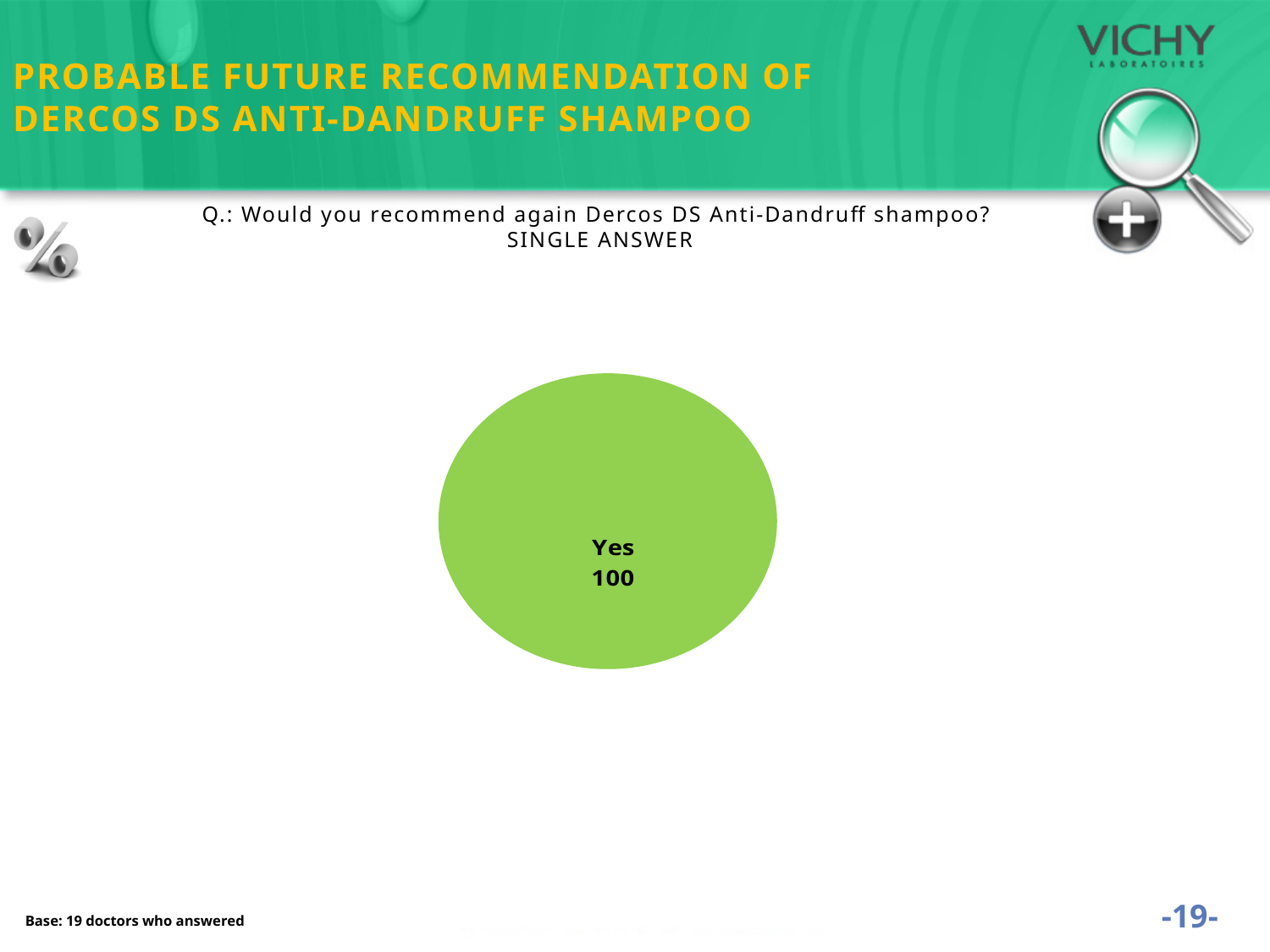
How many slices does the pie chart have? 1 Which category is the largest in the pie chart? Yes What kind of chart is shown on the slide? pie chart What value is shown for the "Yes" slice of the pie chart? 100 What colour is the "Yes" slice of the pie chart? green What is the label of the only slice in the pie chart? Yes What share of the pie does the "Yes" slice represent? 100